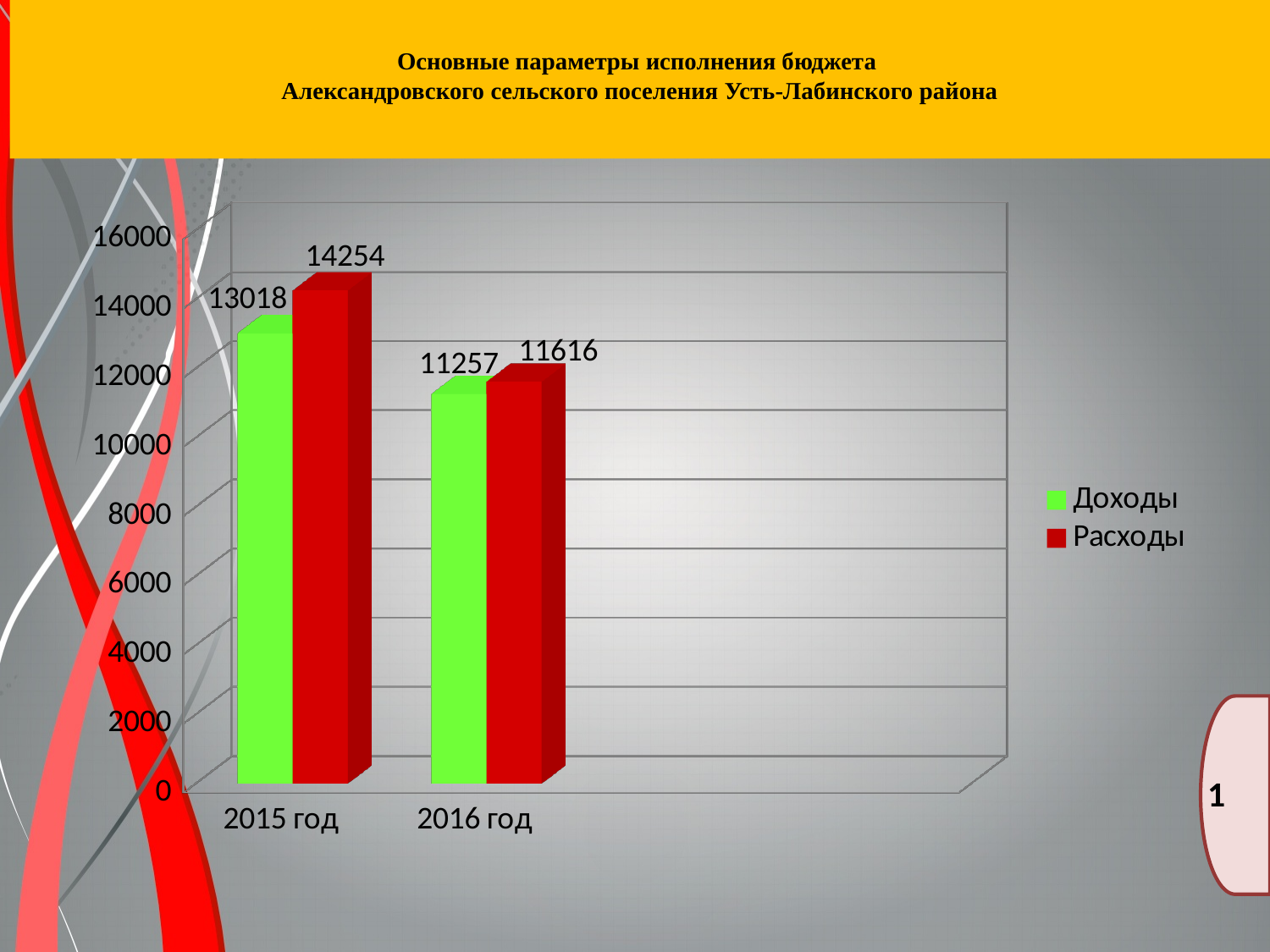
What is the value of Расходы for 2016 год? 11616 What is the difference between Расходы and Доходы in 2015 год? 1236 Do the Доходы values rise or fall from 2015 год to 2016 год? fall How many categories are shown on the x axis? 2 What is the value of Доходы for 2015 год? 13018 Which is larger in 2016 год, Доходы or Расходы? Расходы How many series does the legend list? 2 What is the difference between Доходы in 2015 год and Доходы in 2016 год? 1761 Which year has the highest Расходы value? 2015 год What kind of chart is shown on the slide? bar chart What is the value of Расходы for 2015 год? 14254 Which year has the lowest Доходы value? 2016 год